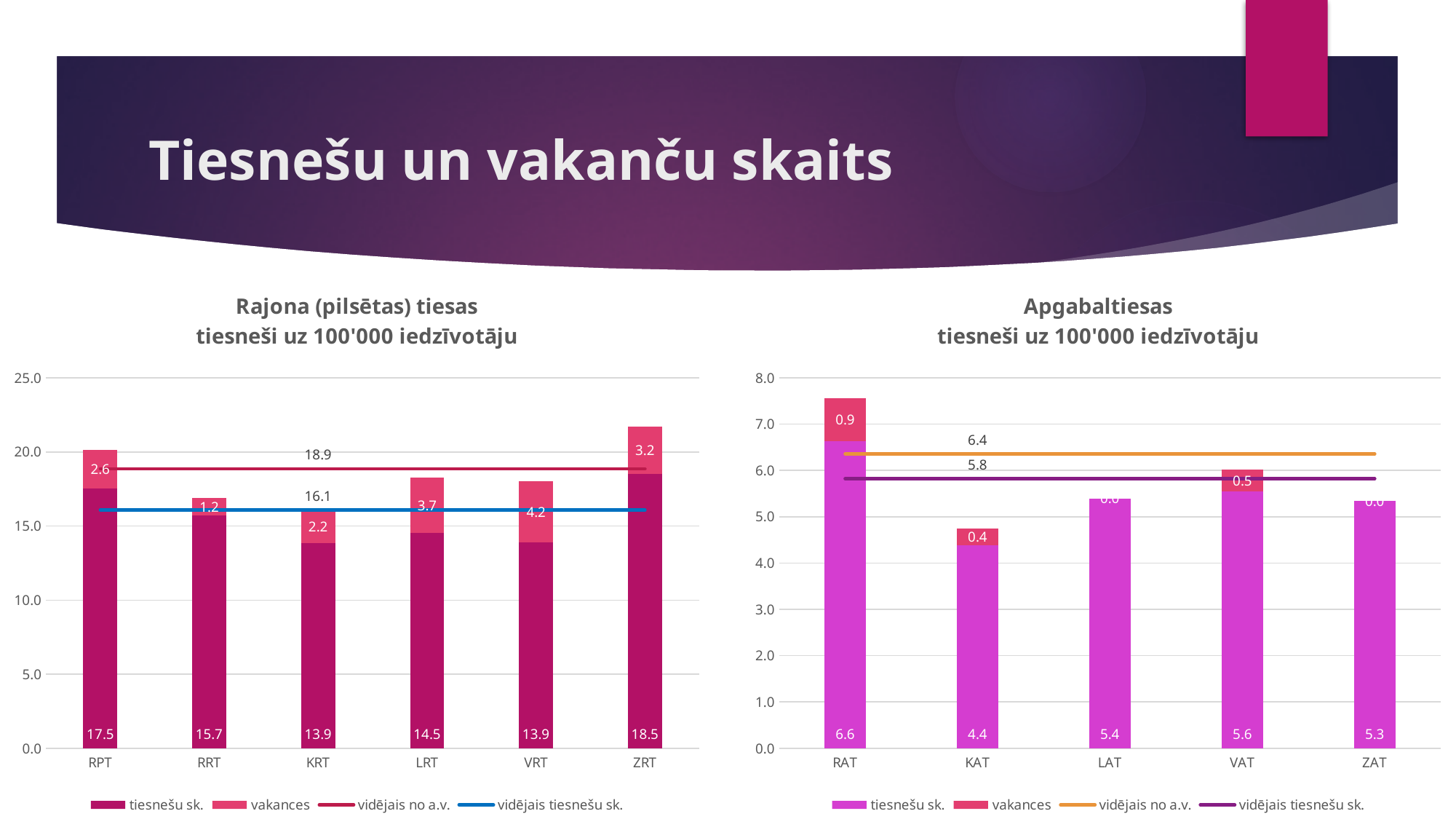
How many series does the legend of the Apgabaltiesas chart list? 4 In the Rajona (pilsētas) tiesas chart, what is the tiesnešu sk. value for RPT? 17.5 In the Apgabaltiesas chart, which category has the lowest tiesnešu sk. value? KAT In the Apgabaltiesas chart, what is the tiesnešu sk. value for KAT? 4.4 In the Rajona (pilsētas) tiesas chart, what is the difference between the tiesnešu sk. values for RPT and RRT? 1.8 In the Rajona (pilsētas) tiesas chart, what is the total of the stacked bar for ZRT (tiesnešu sk. plus vakances)? 21.7 In the Rajona (pilsētas) tiesas chart, what value is labelled on the vidējais no a.v. line? 18.9 In the Rajona (pilsētas) tiesas chart, what is the vakances value for VRT? 4.2 How many categories are shown on the x axis of the Rajona (pilsētas) tiesas chart? 6 In the Rajona (pilsētas) tiesas chart, which category has the highest tiesnešu sk. value? ZRT In the Apgabaltiesas chart, which is larger: the vakances value for RAT or for VAT? RAT What kind of chart is the Apgabaltiesas chart? Stacked bar chart with line series